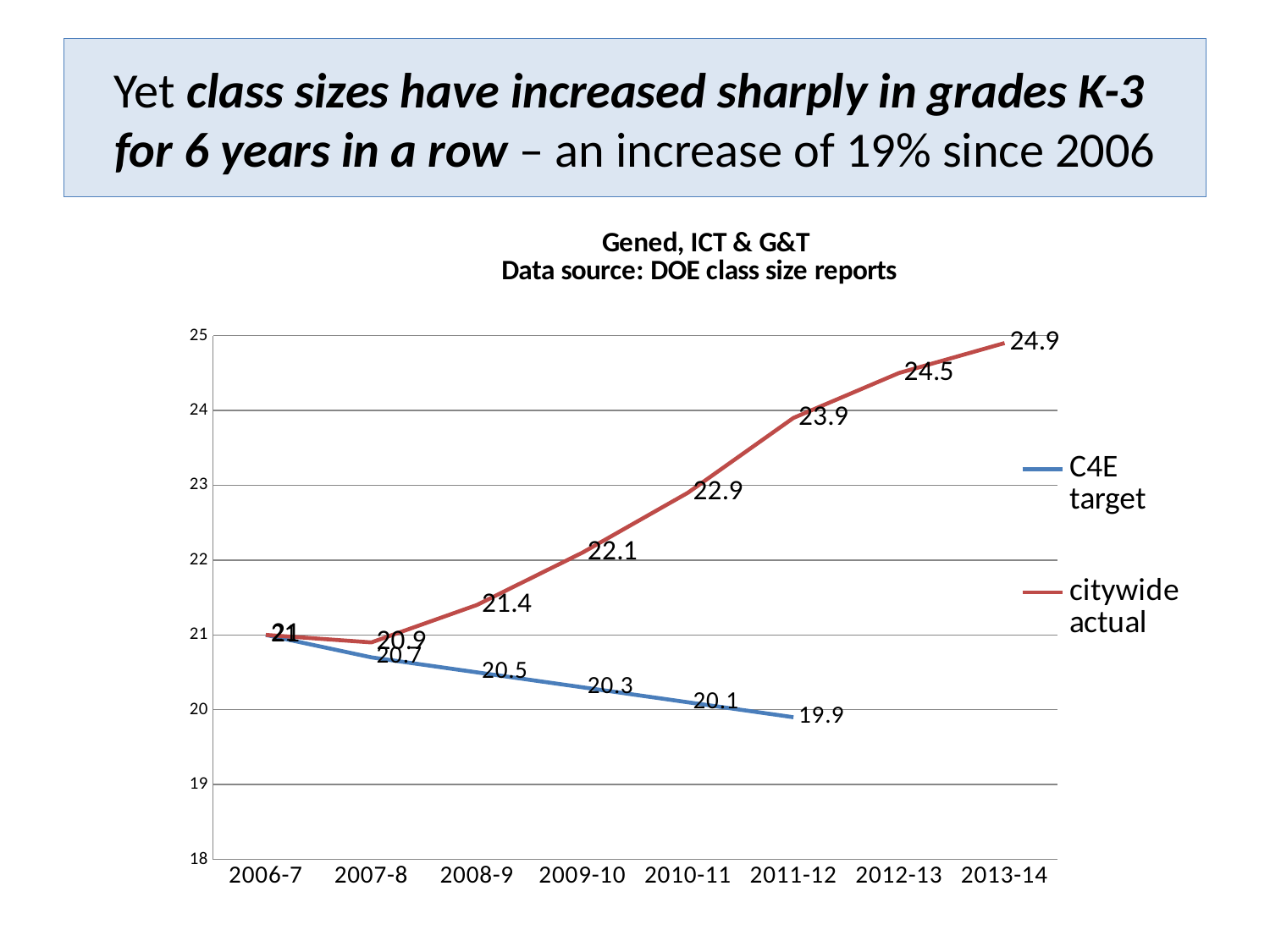
How many years are shown on the x axis? 8 In which year is the citywide actual value highest? 2013-14 How many series does the legend list? 2 What is the C4E target value for 2009-10? 20.3 What is the citywide actual value for 2010-11? 22.9 What is the citywide actual value for 2013-14? 24.9 In which year is the citywide actual value lowest? 2007-8 Which is larger in 2008-9, the citywide actual value or the C4E target value? citywide actual What is the difference between the citywide actual value and the C4E target value in 2011-12? 4 Does the C4E target series rise or fall from 2006-7 to 2011-12? fall What is the C4E target value for 2011-12? 19.9 What kind of chart is shown on the slide? line chart